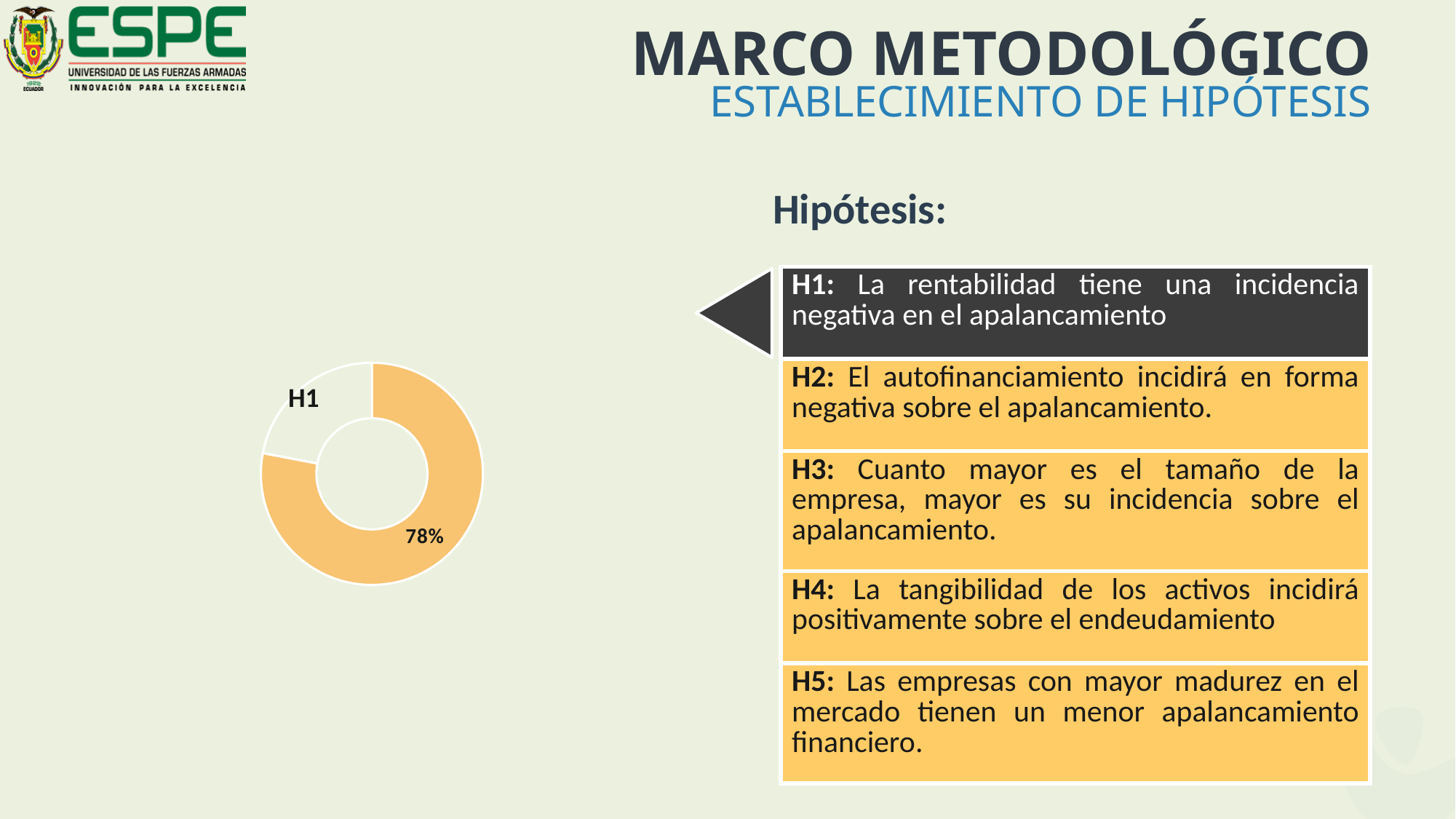
Which slice of the doughnut chart is larger, the orange slice or the light unlabelled slice? The orange slice What share of the doughnut chart does the orange slice represent? 78% What label is shown next to the doughnut chart? H1 Is the value of the orange slice in the doughnut chart greater or less than 50%? greater How many slices does the doughnut chart have? 2 What kind of chart is shown on the left of the slide? Doughnut (pie) chart What percentage is printed on the orange slice of the doughnut chart? 78% What colour is the slice labelled 78% in the doughnut chart? Orange